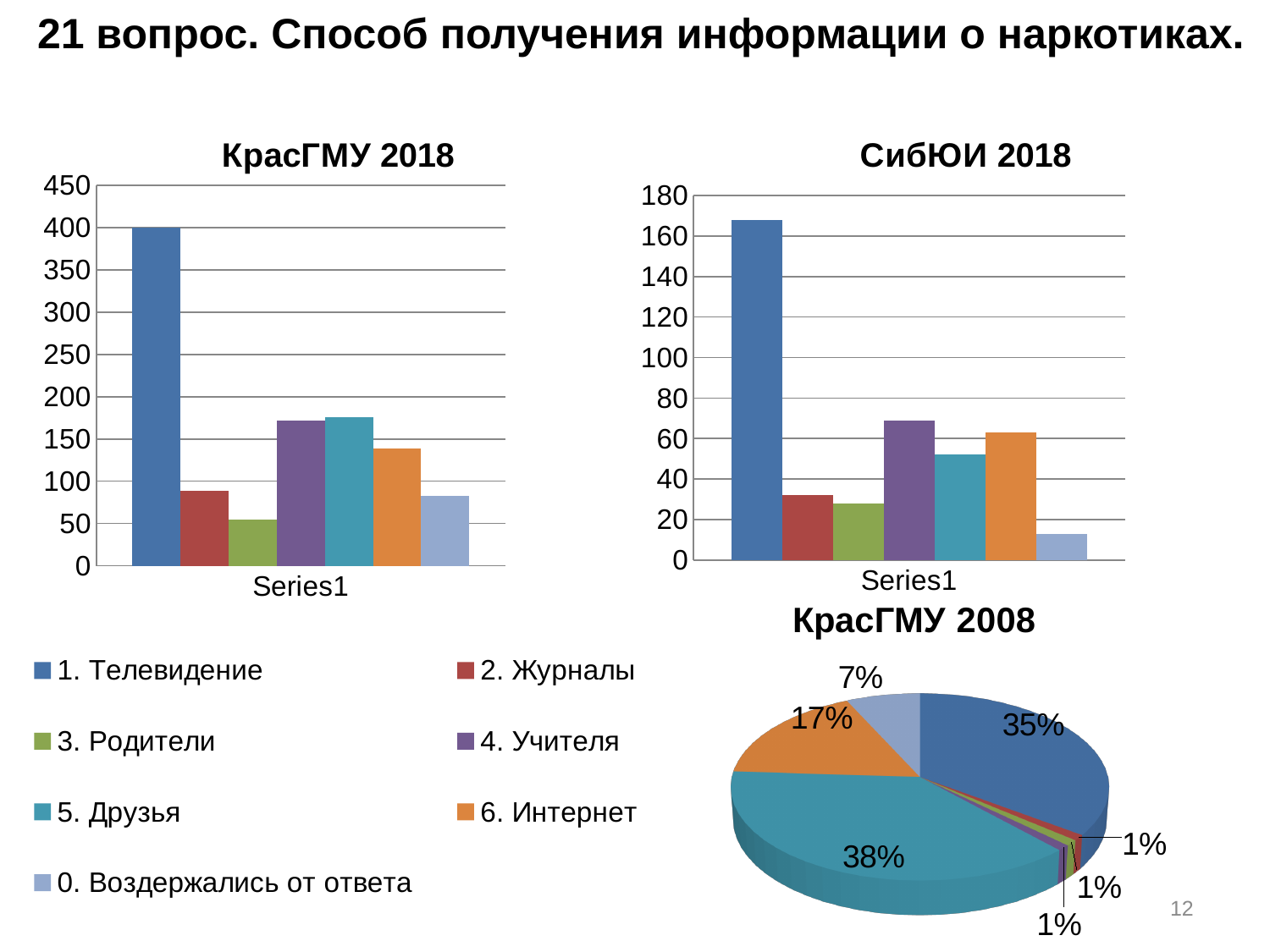
In the КрасГМУ 2008 pie chart, what share does 6. Интернет have? 17% How many categories does the legend list? 7 What kind of chart is the КрасГМУ 2018 chart? bar chart In the КрасГМУ 2018 chart, which is larger: the value for 2. Журналы or the value for 3. Родители? 2. Журналы In the КрасГМУ 2018 chart, is the value for 1. Телевидение greater or less than 350? greater In the СибЮИ 2018 chart, which category has the lowest value? 0. Воздержались от ответа In the СибЮИ 2018 chart, which category has the highest value? 1. Телевидение In the СибЮИ 2018 chart, is the value for 5. Друзья greater or less than 60? less In the КрасГМУ 2008 pie chart, what share does 5. Друзья have? 38% In the КрасГМУ 2018 chart, which category has the highest value? 1. Телевидение In the КрасГМУ 2018 chart, which category has the lowest value? 3. Родители What kind of chart is the КрасГМУ 2008 chart? pie chart